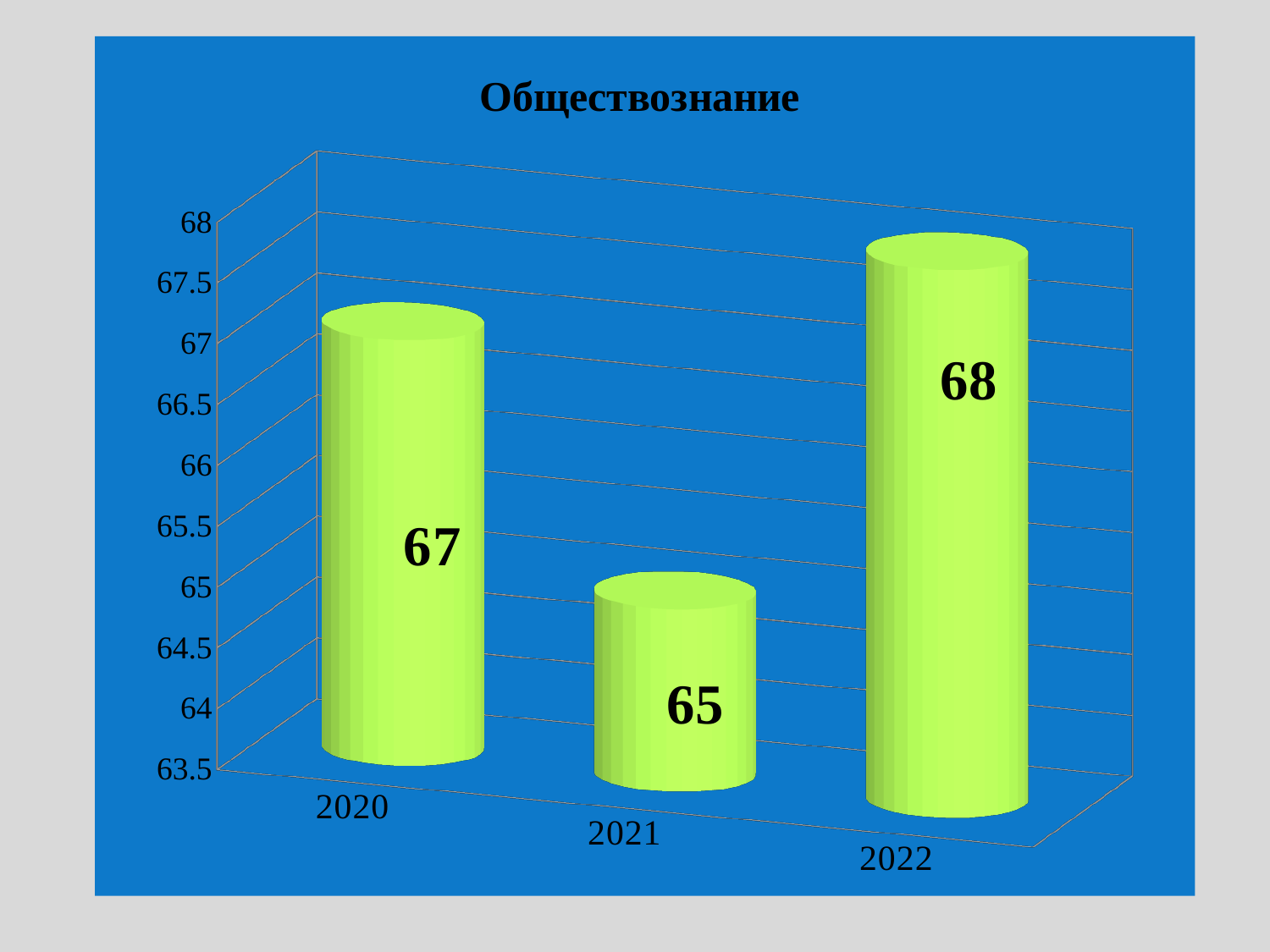
Which year has the lowest value? 2021 What is the difference between the values for 2020 and 2021? 2 What kind of chart is this? bar chart Which year has the highest value? 2022 What is the title of the chart? Обществознание Which is larger, the value for 2020 or the value for 2022? 2022 What is the value for 2021? 65 What is the value for 2022? 68 How many years are shown on the chart? 3 What is the value for 2020? 67 Does the value rise or fall from 2021 to 2022? rise What is the difference between the values for 2022 and 2021? 3